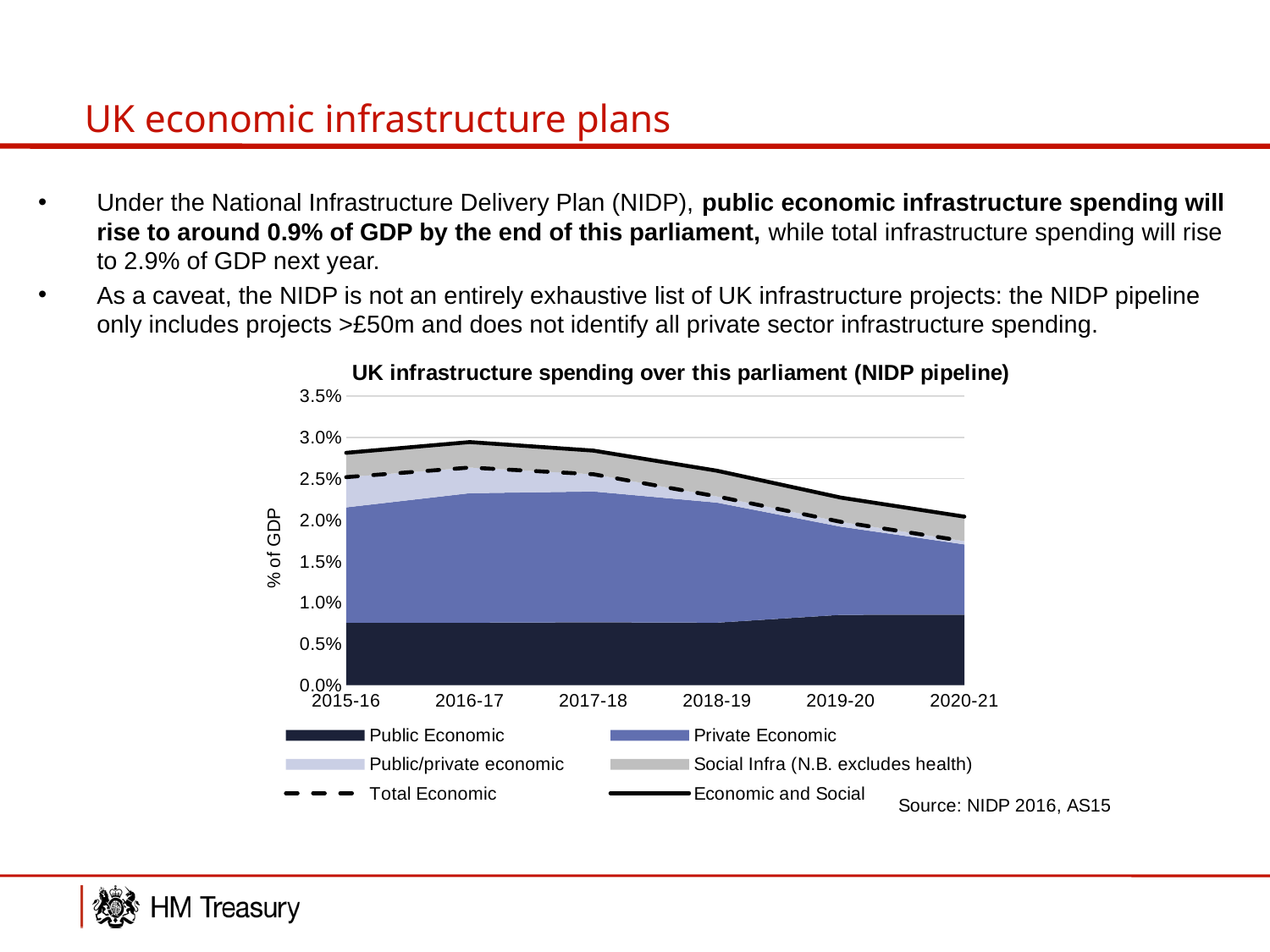
Is the value of the Public Economic area in 2020-21 greater or less than 1.0%? less What is the title of the chart? UK infrastructure spending over this parliament (NIDP pipeline) Is the value of the Economic and Social line in 2015-16 greater or less than 2.5%? greater How many series does the chart's legend list? 6 In which year does the Economic and Social line reach its highest value? 2016-17 Does the Economic and Social line rise or fall between 2016-17 and 2020-21? Fall Is the value of the Total Economic line in 2020-21 greater or less than 2.0%? less How many years are shown on the x axis of the chart? 6 Which series in the legend is drawn as a dashed line? Total Economic What kind of chart is shown on the slide? Combination area and line chart In which year does the Economic and Social line reach its lowest value? 2020-21